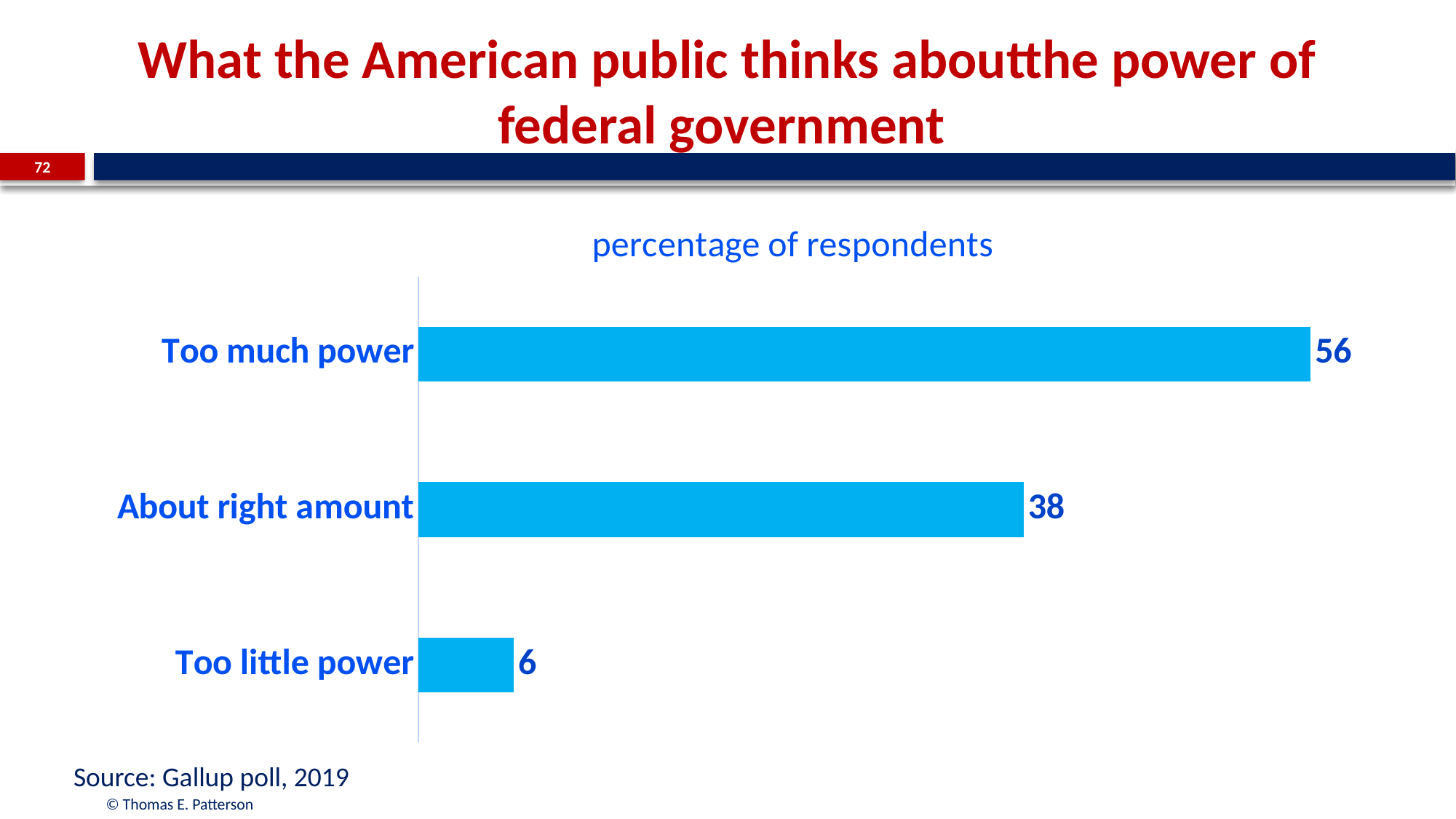
What is the value for "Too little power"? 6 What percentage of respondents said the federal government has too much power? 56 What is the difference between the values for "Too much power" and "About right amount"? 18 How many categories are shown in the chart? 3 What is the source of the data shown in the chart? Gallup poll, 2019 Which category has the highest percentage of respondents? Too much power What is the title of the chart? percentage of respondents What is the difference between the values for "About right amount" and "Too little power"? 32 What is the value for "About right amount"? 38 What kind of chart is shown on the slide? Bar chart Which category has the lowest percentage of respondents? Too little power Which is larger, the value for "Too much power" or the value for "About right amount"? Too much power